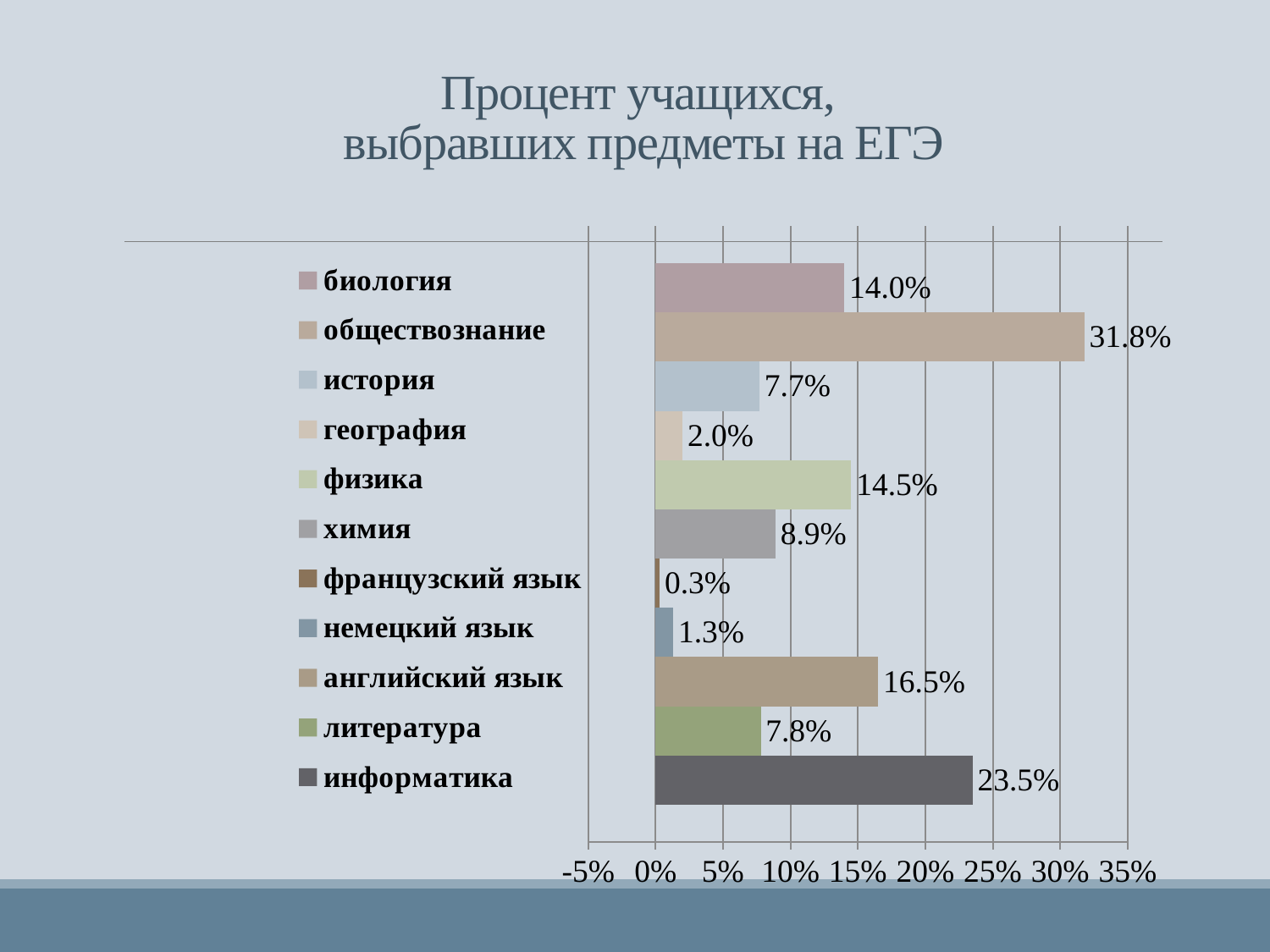
Which subject has the highest percentage? обществознание What kind of chart is shown on the slide? bar chart What is the value for обществознание? 31.8% What is the title of the chart? Процент учащихся, выбравших предметы на ЕГЭ What is the difference between the values for обществознание and информатика? 8.3% What is the difference between the values for история and литература? 0.1% How many subjects are shown in the chart? 11 Is the value for английский язык greater or less than 15%? greater Which is larger, the value for физика or the value for биология? физика What is the value for французский язык? 0.3% What is the value for информатика? 23.5% Which subject has the lowest percentage? французский язык